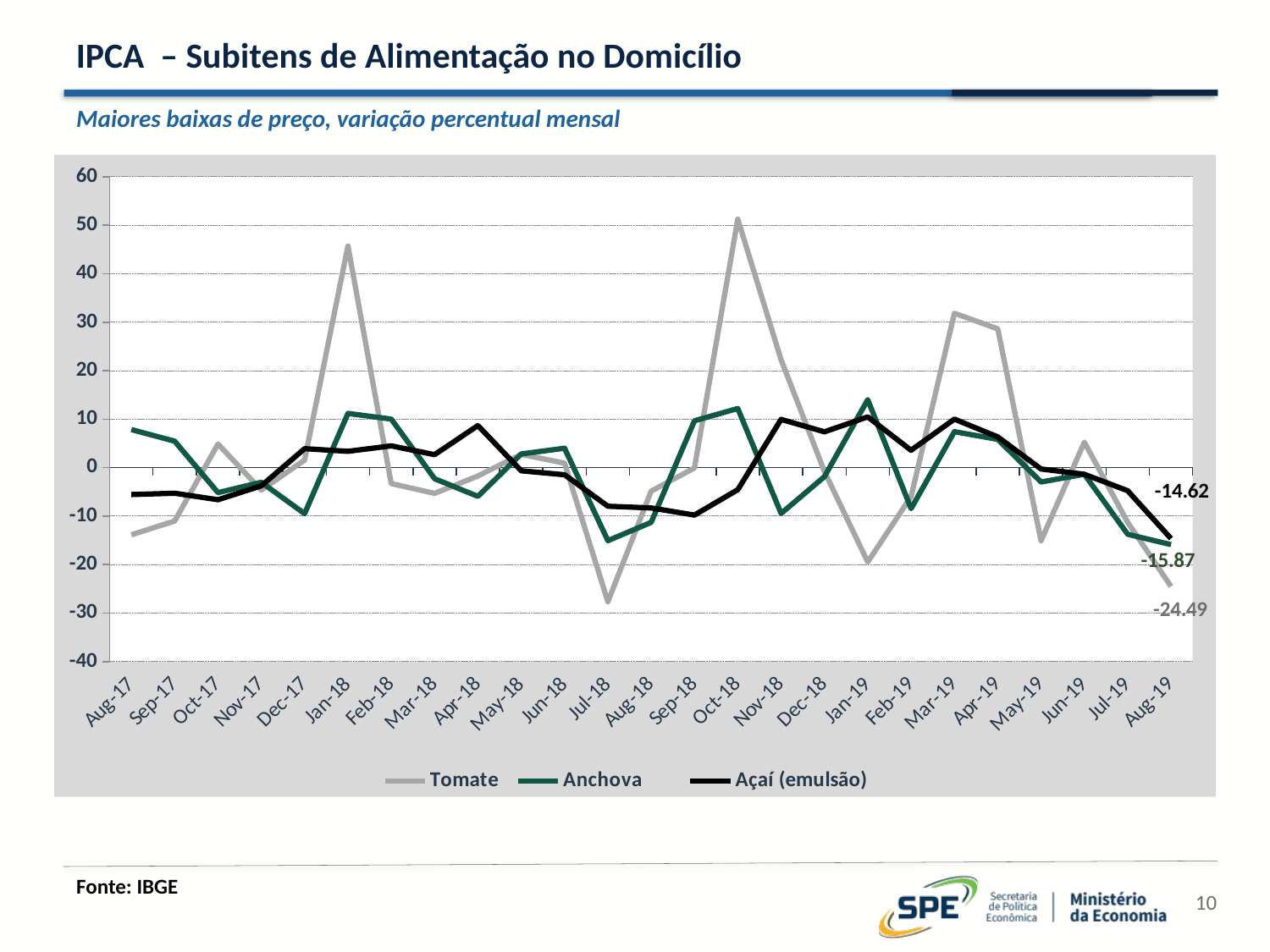
What is the value for Açaí (emulsão) in Aug-19? -14.62 How many series does the legend list? 3 Is the value for Tomate in Jul-18 greater or less than -20? less What is the value for Anchova in Aug-19? -15.87 What is the difference between the Açaí (emulsão) value and the Anchova value in Aug-19? 1.25 What is the value for Tomate in Aug-19? -24.49 How many months are shown on the x axis? 25 What are the three series named in the legend? Tomate, Anchova, Açaí (emulsão) What kind of chart is shown on the slide? line chart In Aug-19, which is larger: the value for Tomate or the value for Açaí (emulsão)? Açaí (emulsão) Which series has the lowest value in Aug-19? Tomate Is the value for Tomate in Oct-18 greater or less than 40? greater